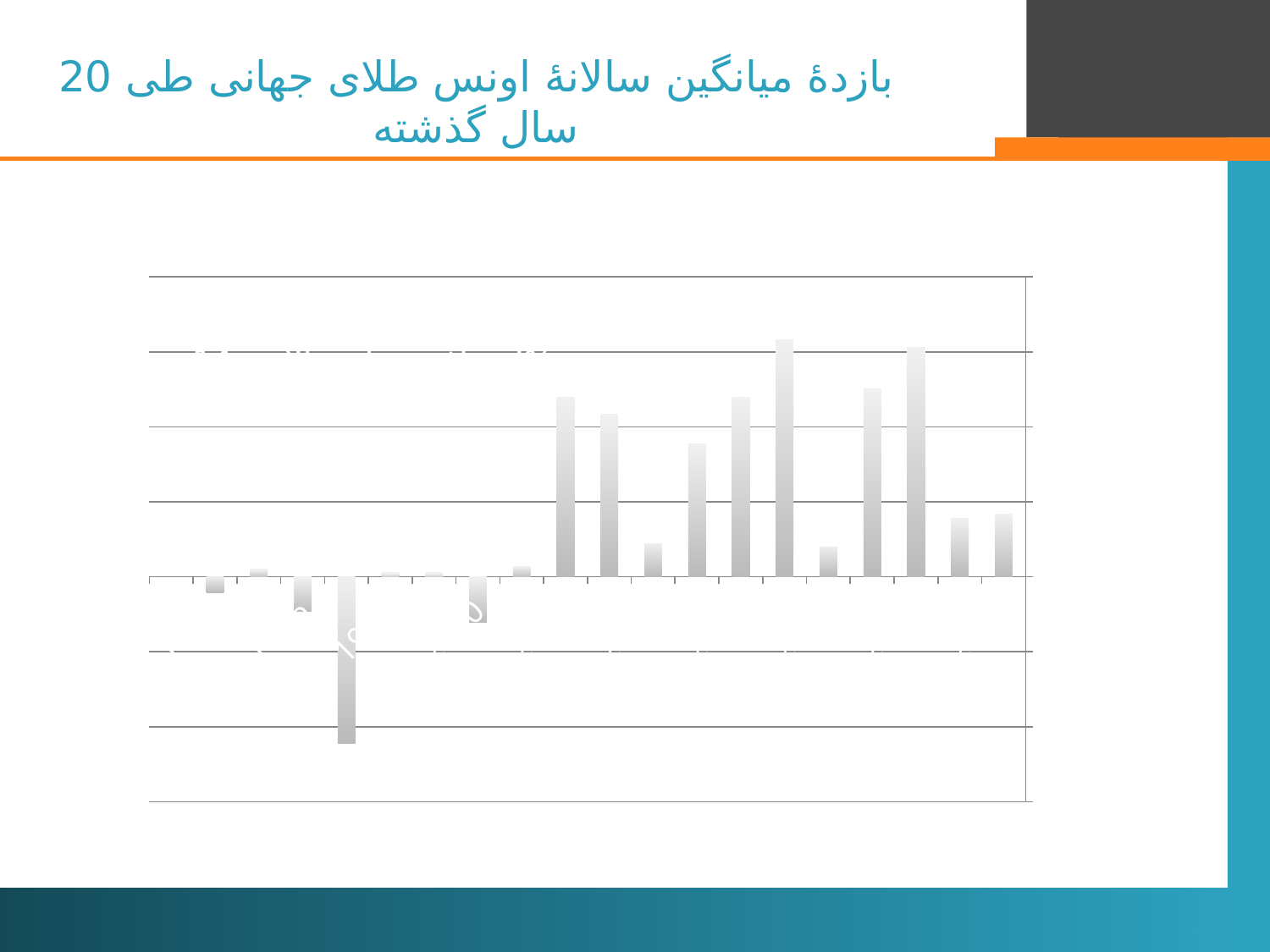
Does the chart include bars that extend below the zero line (negative values)? yes What is the title of the slide containing the chart? بازدهٔ میانگین سالانهٔ اونس طلای جهانی طی 20 سال گذشته What kind of chart is shown on the slide? bar chart Are there more bars above the zero line or below it? above